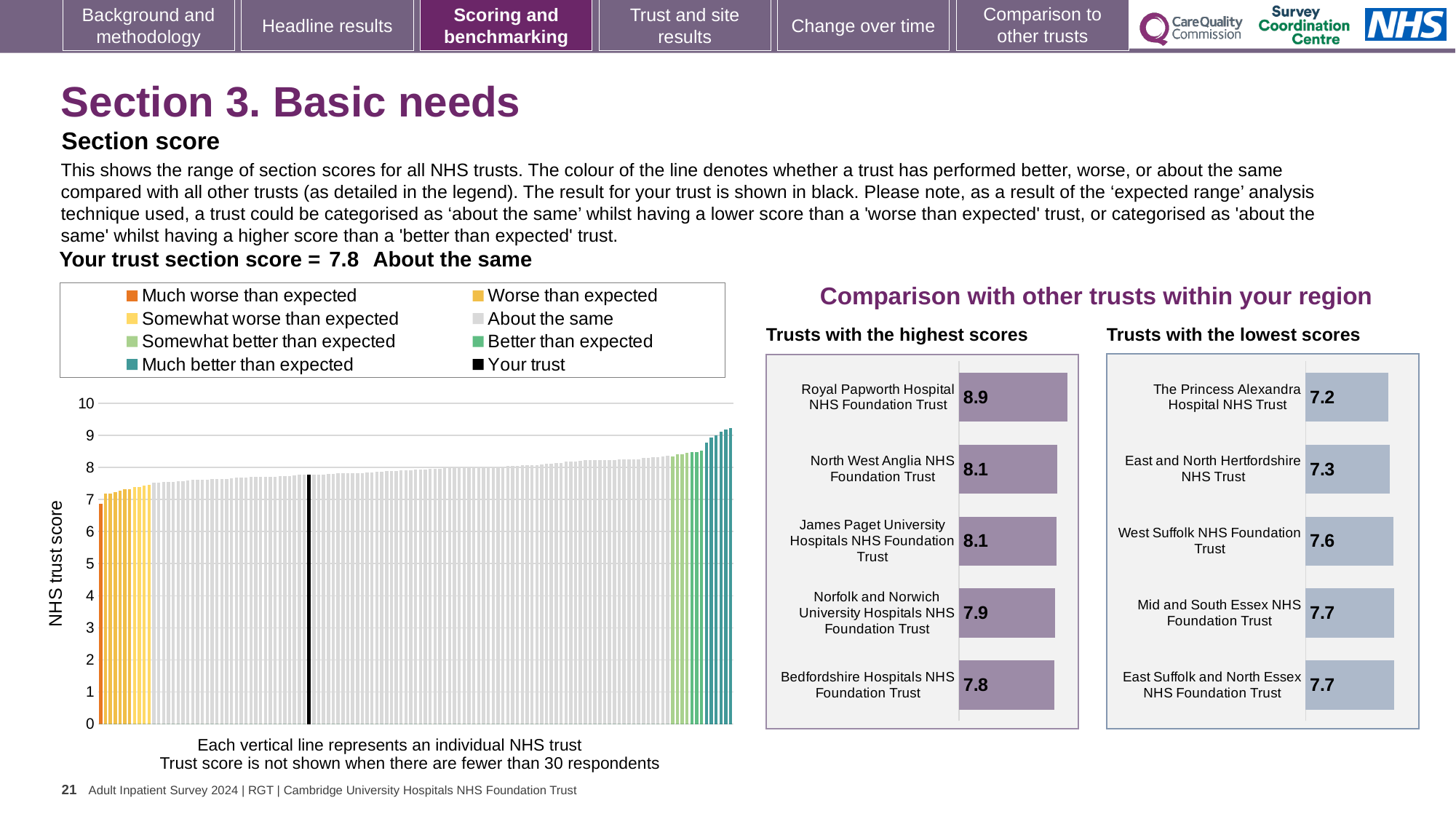
How many trusts are listed in the 'Trusts with the highest scores' chart? 5 In the 'Trusts with the highest scores' chart, what is the difference between the scores of Royal Papworth Hospital NHS Foundation Trust and Bedfordshire Hospitals NHS Foundation Trust? 1.1 How many entries does the legend of the main 'NHS trust score' chart list? 8 In the 'Trusts with the highest scores' chart, what is the score for Norfolk and Norwich University Hospitals NHS Foundation Trust? 7.9 In the 'Trusts with the highest scores' chart, which trust has the highest score? Royal Papworth Hospital NHS Foundation Trust In the 'Trusts with the highest scores' chart, what is the score for Royal Papworth Hospital NHS Foundation Trust? 8.9 In the 'Trusts with the lowest scores' chart, which trust has the lowest score? The Princess Alexandra Hospital NHS Trust In the 'Trusts with the lowest scores' chart, which has the larger score: East and North Hertfordshire NHS Trust or Mid and South Essex NHS Foundation Trust? Mid and South Essex NHS Foundation Trust In the 'Trusts with the lowest scores' chart, what is the difference between the scores of West Suffolk NHS Foundation Trust and The Princess Alexandra Hospital NHS Trust? 0.4 In the 'Trusts with the lowest scores' chart, what is the score for West Suffolk NHS Foundation Trust? 7.6 What kind of chart is the main chart showing the NHS trust score for all trusts? Bar chart In the main 'NHS trust score' chart, is the value for the black bar (your trust) greater or less than 7? greater